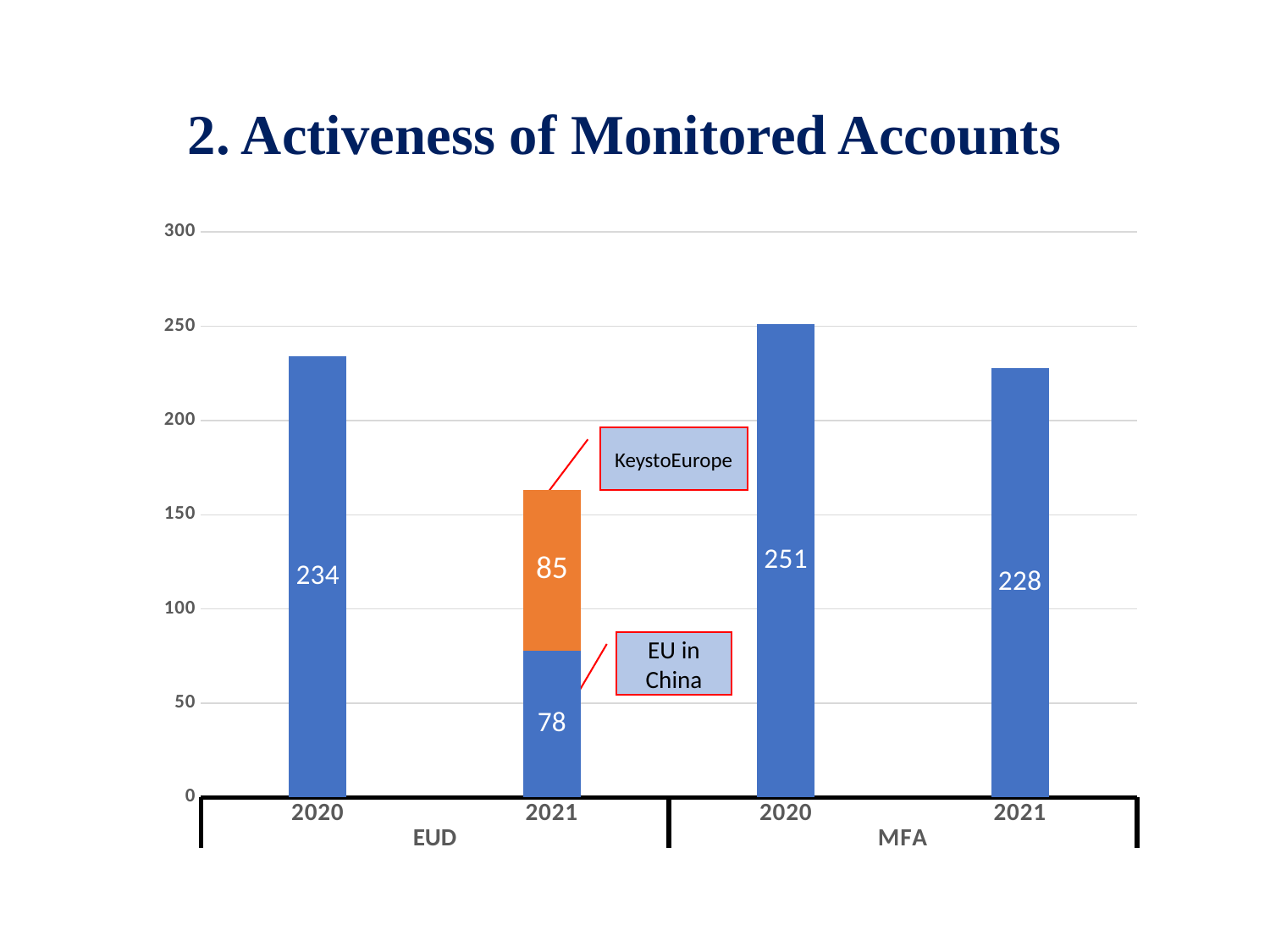
What is the value of the EU in China segment in the EUD 2021 bar? 78 What is the value of the KeystoEurope segment in the EUD 2021 bar? 85 What is the value for MFA in 2021? 228 What is the difference between the MFA 2020 and MFA 2021 values? 23 What type of chart is shown on the slide? Stacked bar chart Which bar has the lowest total value? EUD 2021 What is the value for MFA in 2020? 251 Which bar has the highest value? MFA 2020 Which is larger, the EUD 2020 value or the MFA 2021 value? EUD 2020 What is the total of the stacked EUD 2021 bar? 163 What is the value for EUD in 2020? 234 What is the title of the slide? 2. Activeness of Monitored Accounts